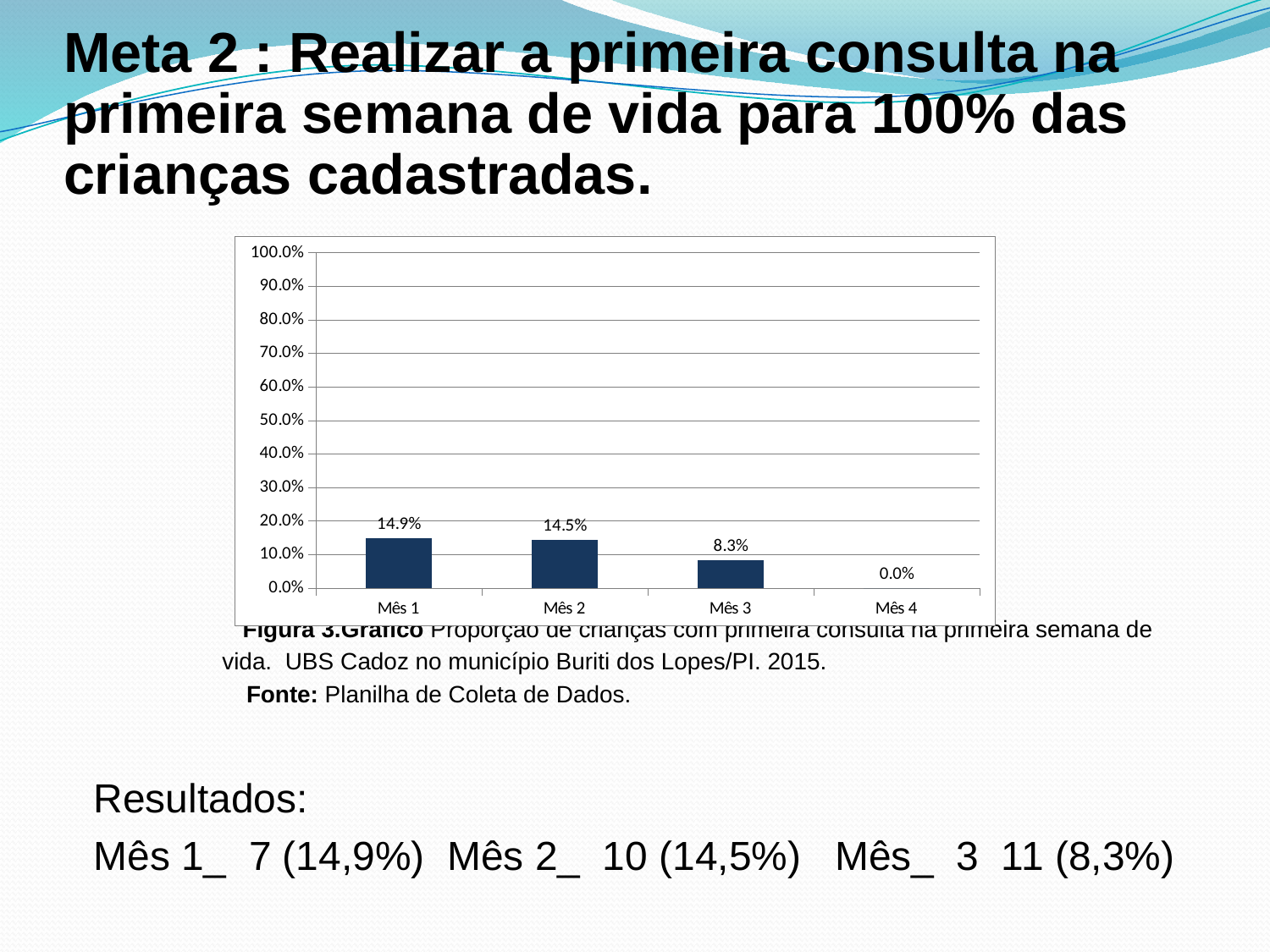
Is the value for Mês 1 greater or less than 20.0%? less What is the value for Mês 3? 8.3% What is the difference between the values for Mês 1 and Mês 3? 6.6% What kind of chart is shown on the slide? bar chart What is the difference between the values for Mês 2 and Mês 3? 6.2% Do the values rise or fall from Mês 1 to Mês 4? fall How many months are shown on the x axis? 4 Which month has the highest value? Mês 1 What is the value for Mês 4? 0.0% What is the value for Mês 1? 14.9% Which month has the lowest value? Mês 4 Which is larger, the value for Mês 2 or the value for Mês 3? Mês 2